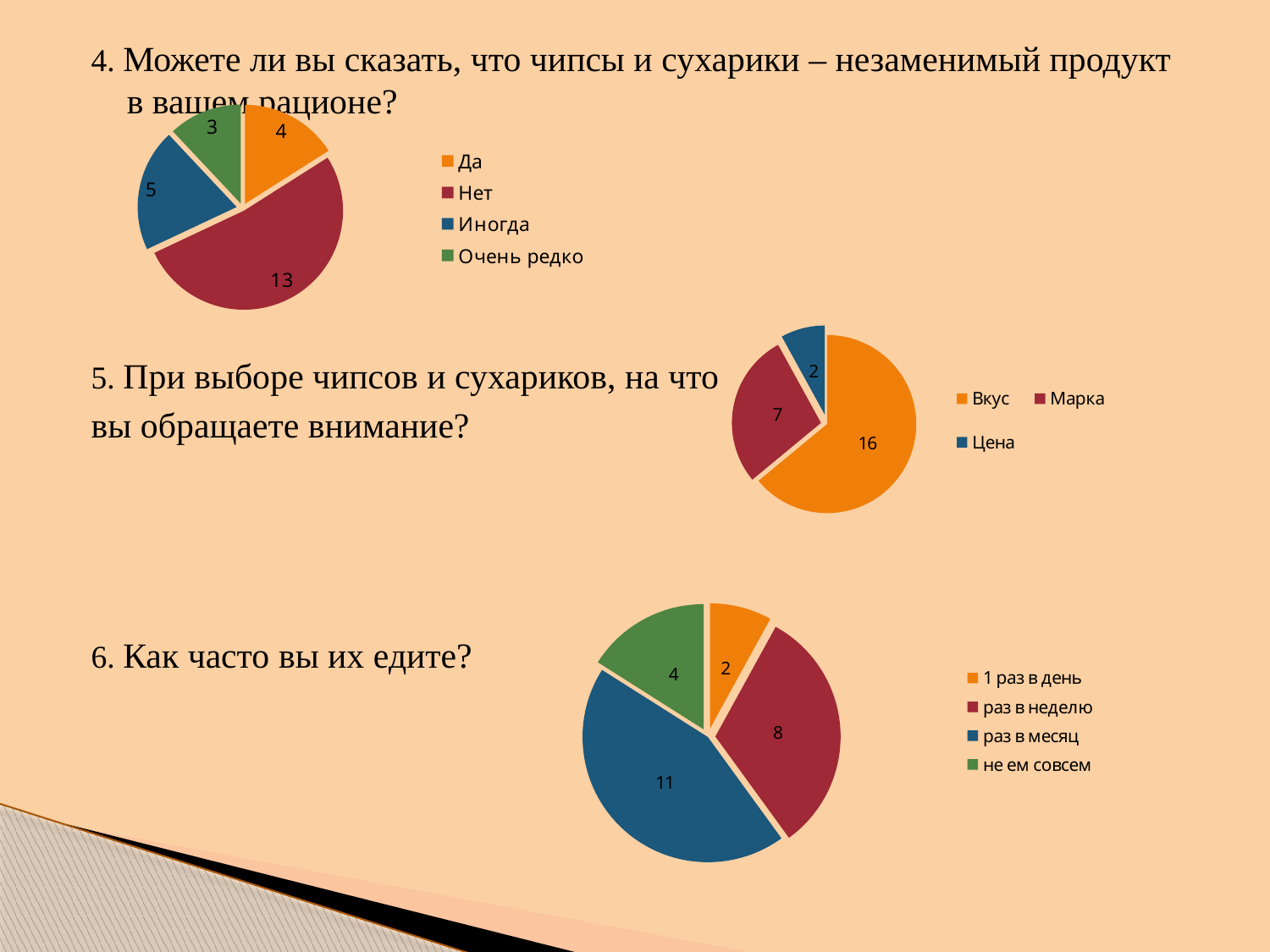
In the middle-right pie chart (question 5), what share of the total does "Вкус" represent? 64% In the bottom pie chart (question 6), which is larger: "раз в неделю" or "не ем совсем"? раз в неделю In the top-left pie chart (question 4), what is the value for "Нет"? 13 How many categories does the legend of the top-left pie chart (question 4) list? 4 In the top-left pie chart (question 4), what is the difference between "Нет" and "Да"? 9 In the top-left pie chart (question 4), which category has the smallest value? Очень редко What type of chart is used for question 5 (middle-right)? Pie chart In the middle-right pie chart (question 5), which category has the largest value? Вкус In the bottom pie chart (question 6), what colour is the slice for "раз в месяц"? Blue In the bottom pie chart (question 6), what is the total of all slices? 25 In the middle-right pie chart (question 5), what is the value for "Марка"? 7 In the bottom pie chart (question 6), what is the value for "раз в месяц"? 11